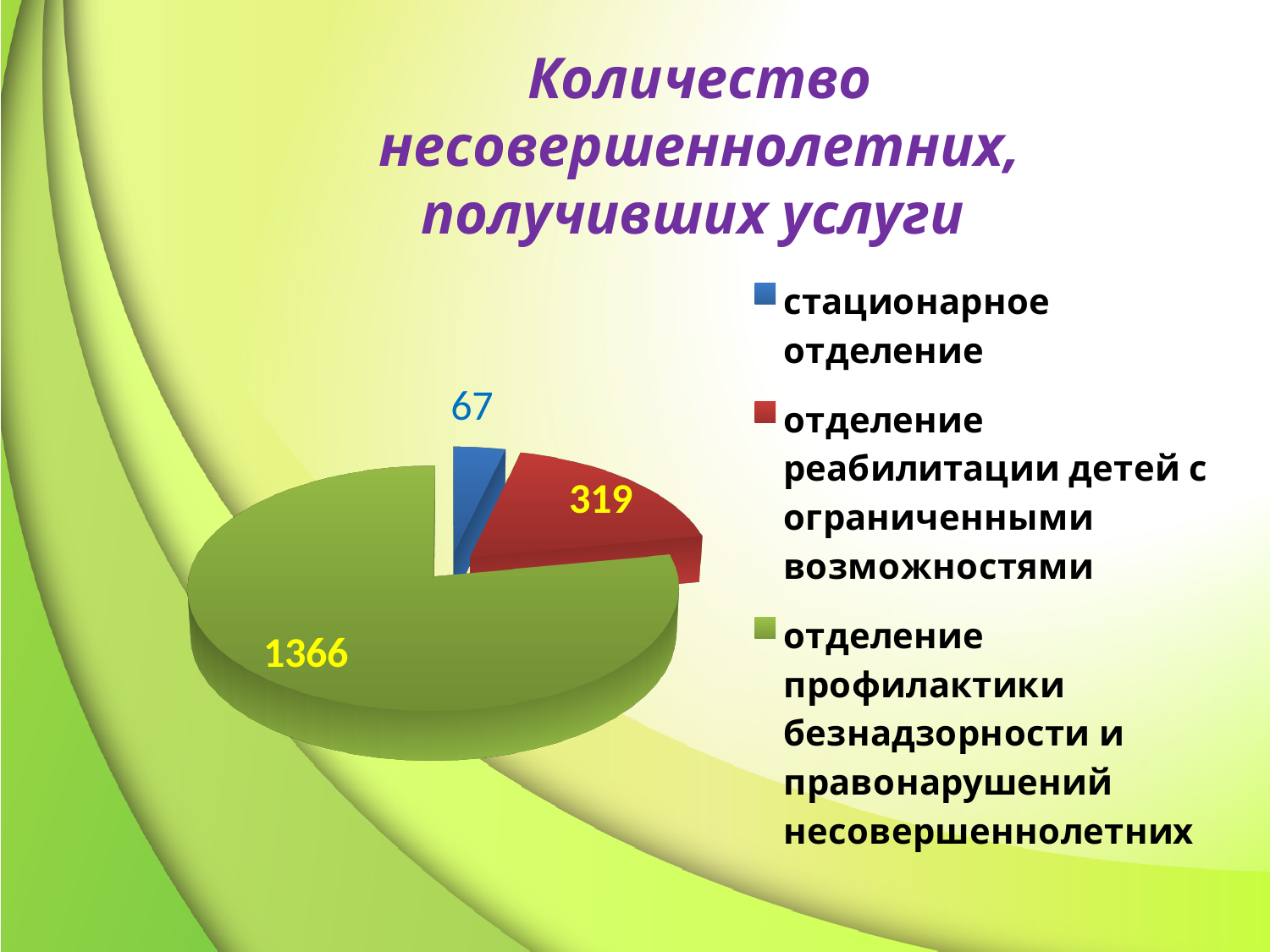
Which category has the smallest slice of the pie? стационарное отделение How many slices does the pie chart have? 3 What is the difference between the values for отделение профилактики безнадзорности и правонарушений несовершеннолетних and отделение реабилитации детей с ограниченными возможностями? 1047 What type of chart is shown on the slide? pie chart What is the value for отделение реабилитации детей с ограниченными возможностями? 319 What is the title of the chart? Количество несовершеннолетних, получивших услуги What is the value for стационарное отделение? 67 What colour is the slice for стационарное отделение? blue What is the difference between the values for отделение реабилитации детей с ограниченными возможностями and стационарное отделение? 252 What is the value for отделение профилактики безнадзорности и правонарушений несовершеннолетних? 1366 Which is larger: the value for отделение реабилитации детей с ограниченными возможностями or the value for стационарное отделение? отделение реабилитации детей с ограниченными возможностями Which category has the largest slice of the pie? отделение профилактики безнадзорности и правонарушений несовершеннолетних